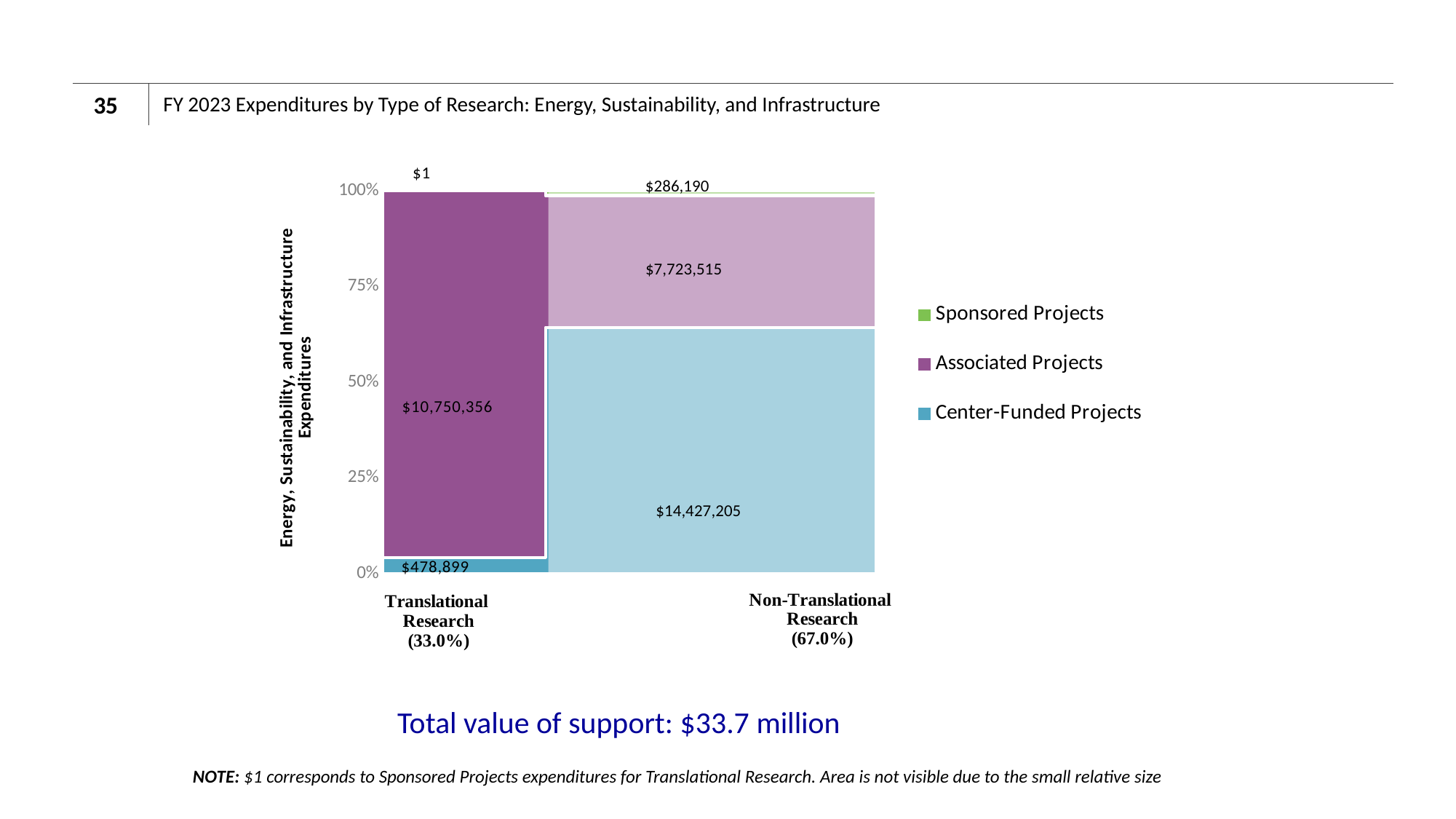
What is the Sponsored Projects expenditure for Non-Translational Research? $286,190 Which series has the largest expenditure within Non-Translational Research? Center-Funded Projects Which series has the smallest expenditure within Translational Research? Sponsored Projects Which is larger: Associated Projects expenditure for Translational Research or for Non-Translational Research? Translational Research What is the Associated Projects expenditure for Translational Research? $10,750,356 What is the Center-Funded Projects expenditure for Non-Translational Research? $14,427,205 What is the Center-Funded Projects expenditure for Translational Research? $478,899 What type of chart is shown on the slide? Stacked bar chart What is the difference between the Center-Funded Projects expenditures for Non-Translational Research and Translational Research? $13,948,306 What is the Sponsored Projects expenditure for Translational Research? $1 What share of total expenditures does Non-Translational Research represent, according to the axis label? 67.0% How many series does the legend list? 3